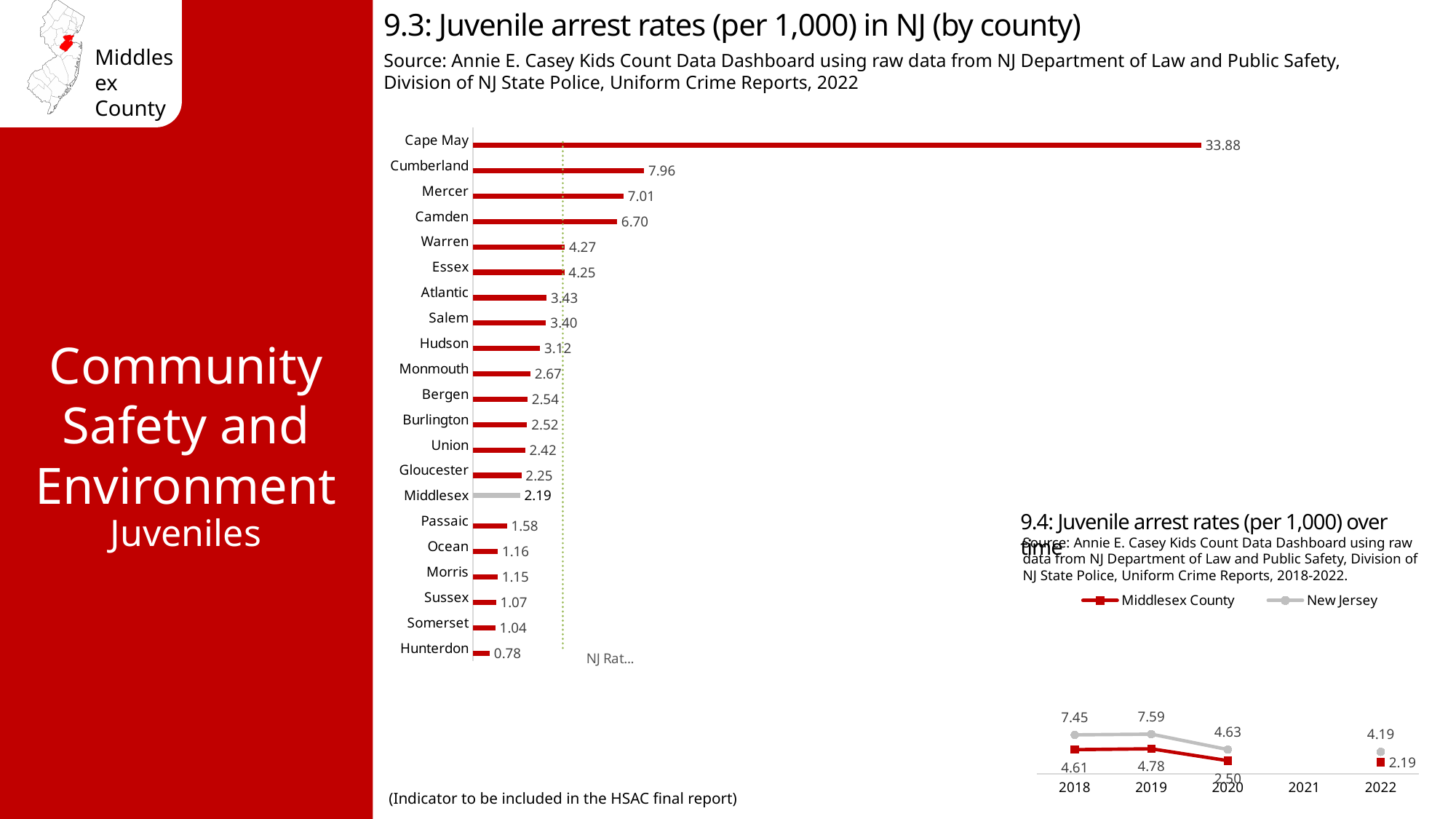
In the chart '9.4: Juvenile arrest rates (per 1,000) over time', what is the value for New Jersey in 2019? 7.59 In the chart '9.3: Juvenile arrest rates (per 1,000) in NJ (by county)', which county has the highest rate? Cape May In the chart '9.4: Juvenile arrest rates (per 1,000) over time', what is the difference between New Jersey and Middlesex County in 2022? 2.00 In the chart '9.3: Juvenile arrest rates (per 1,000) in NJ (by county)', how many counties are shown? 21 In the chart '9.3: Juvenile arrest rates (per 1,000) in NJ (by county)', which county has the lowest rate? Hunterdon What kind of chart is '9.3: Juvenile arrest rates (per 1,000) in NJ (by county)'? Bar chart In the chart '9.3: Juvenile arrest rates (per 1,000) in NJ (by county)', what is the difference between Cumberland and Mercer? 0.95 In the chart '9.4: Juvenile arrest rates (per 1,000) over time', how many series does the legend list? 2 In the chart '9.3: Juvenile arrest rates (per 1,000) in NJ (by county)', which is larger, Essex or Atlantic? Essex In the chart '9.4: Juvenile arrest rates (per 1,000) over time', what is the value for Middlesex County in 2020? 2.50 In the chart '9.3: Juvenile arrest rates (per 1,000) in NJ (by county)', what is the value for Camden? 6.70 In the chart '9.3: Juvenile arrest rates (per 1,000) in NJ (by county)', what is the value for Middlesex? 2.19